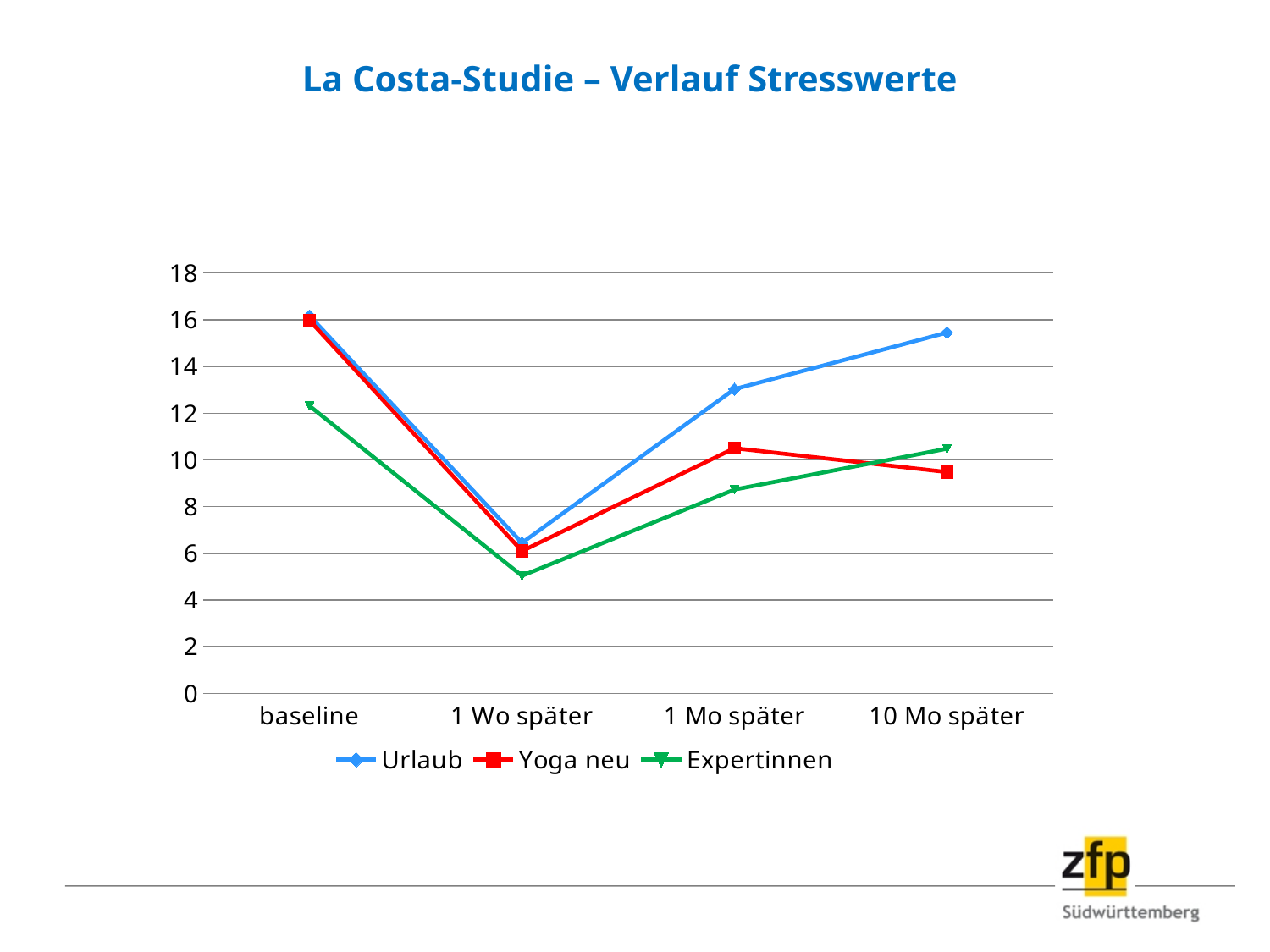
Is the value for Yoga neu at 1 Wo später greater or less than 8? less How many series does the legend list? 3 At which time point does the Expertinnen series reach its lowest value? 1 Wo später Is the value for Expertinnen at baseline greater or less than 14? less Do the values of all three series rise or fall from baseline to 1 Wo später? fall Which series is shown in green in the legend? Expertinnen What is the title of the chart? La Costa-Studie – Verlauf Stresswerte At 10 Mo später, which series has the larger value, Urlaub or Yoga neu? Urlaub How many time points are shown on the x axis? 4 What kind of chart is shown on the slide? line chart Is the value for Expertinnen at 1 Wo später greater or less than 6? less